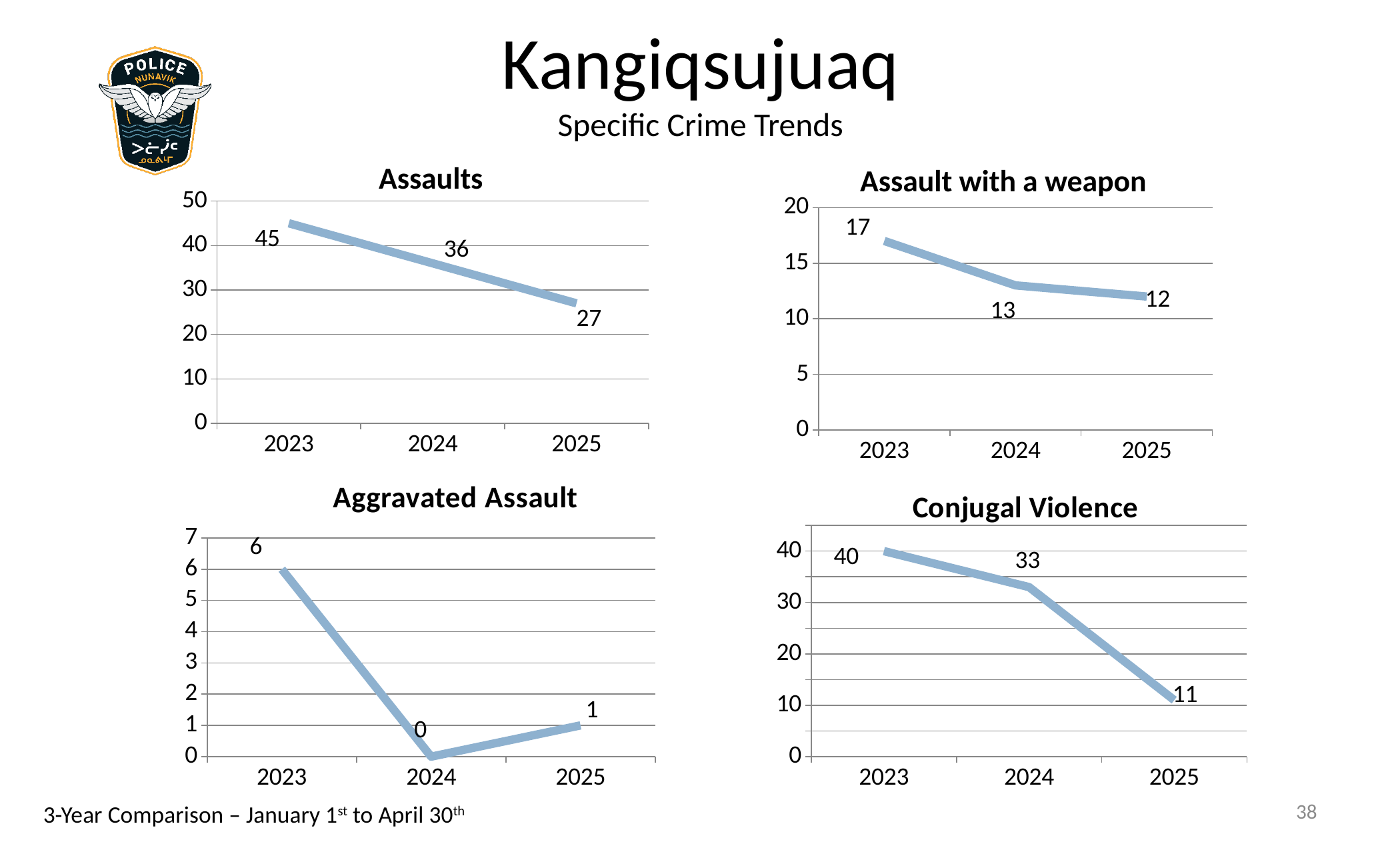
How many years are plotted on the x axis of the Assault with a weapon chart? 3 In the Assault with a weapon chart, which year has the highest value? 2023 In the Aggravated Assault chart, what is the value for 2025? 1 In the Assaults chart, what is the difference between the 2023 and 2025 values? 18 What kind of chart is the Assaults chart? line chart In the Assault with a weapon chart, what is the value for 2024? 13 In the Assaults chart, do the values rise or fall from 2023 to 2025? fall In the Assaults chart, what is the value for 2023? 45 In the Aggravated Assault chart, which year has the lowest value? 2024 In the Conjugal Violence chart, what is the value for 2025? 11 In the Conjugal Violence chart, which is larger, the value for 2023 or the value for 2024? 2023 In the Conjugal Violence chart, what is the difference between the 2024 and 2025 values? 22